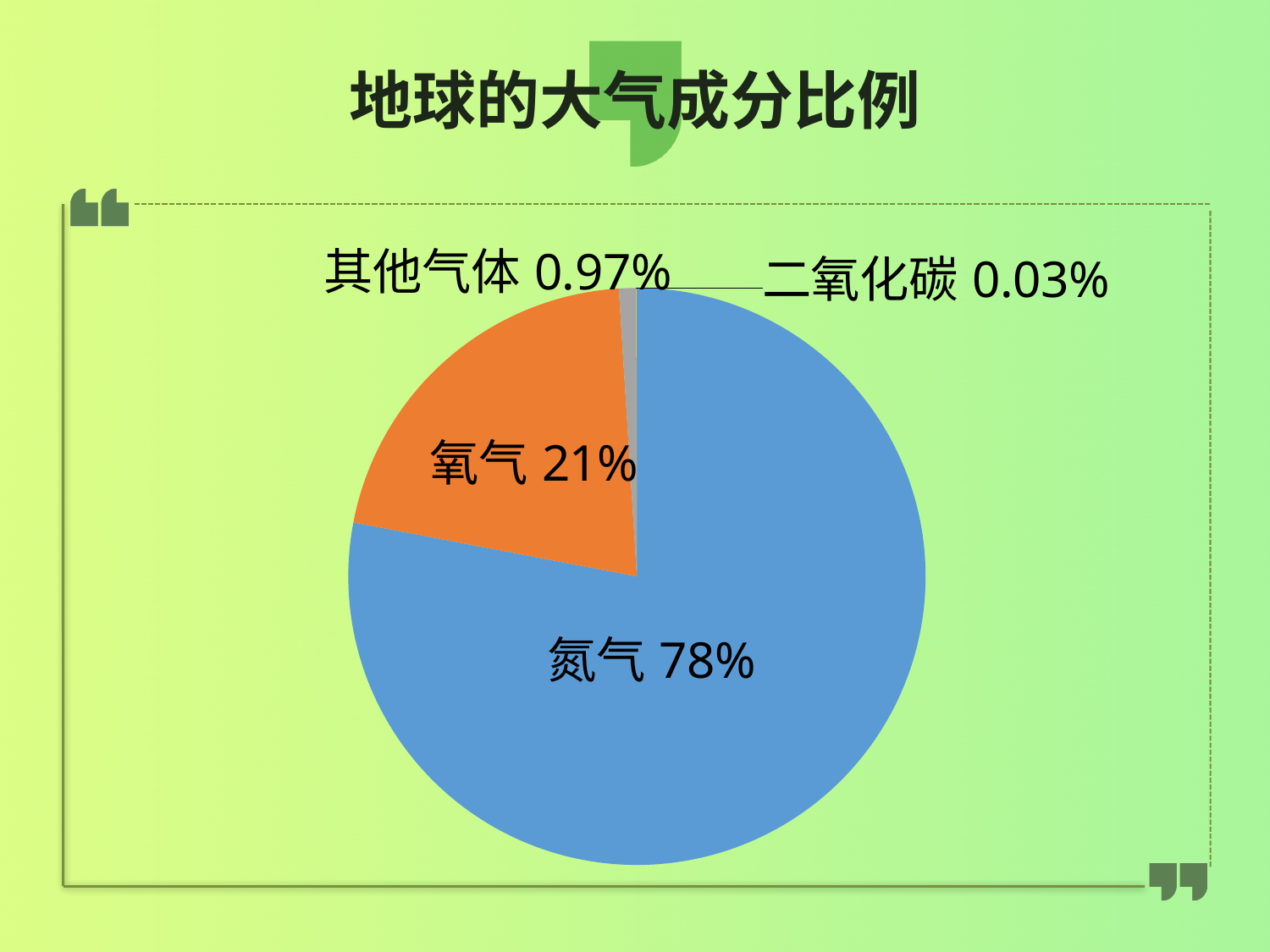
What is the difference between the 氮气 and 氧气 percentages? 57% What percentage of the pie is 其他气体? 0.97% How many slices does the pie chart have? 4 Which is larger, 其他气体 or 二氧化碳? 其他气体 What type of chart is shown on the slide? pie chart What colour is the 氧气 slice? orange Which slice of the pie is the largest? 氮气 What percentage of the pie is 氧气? 21% What percentage of the pie is 氮气? 78% What is the title of the chart? 地球的大气成分比例 What percentage of the pie is 二氧化碳? 0.03% Which slice of the pie is the smallest? 二氧化碳